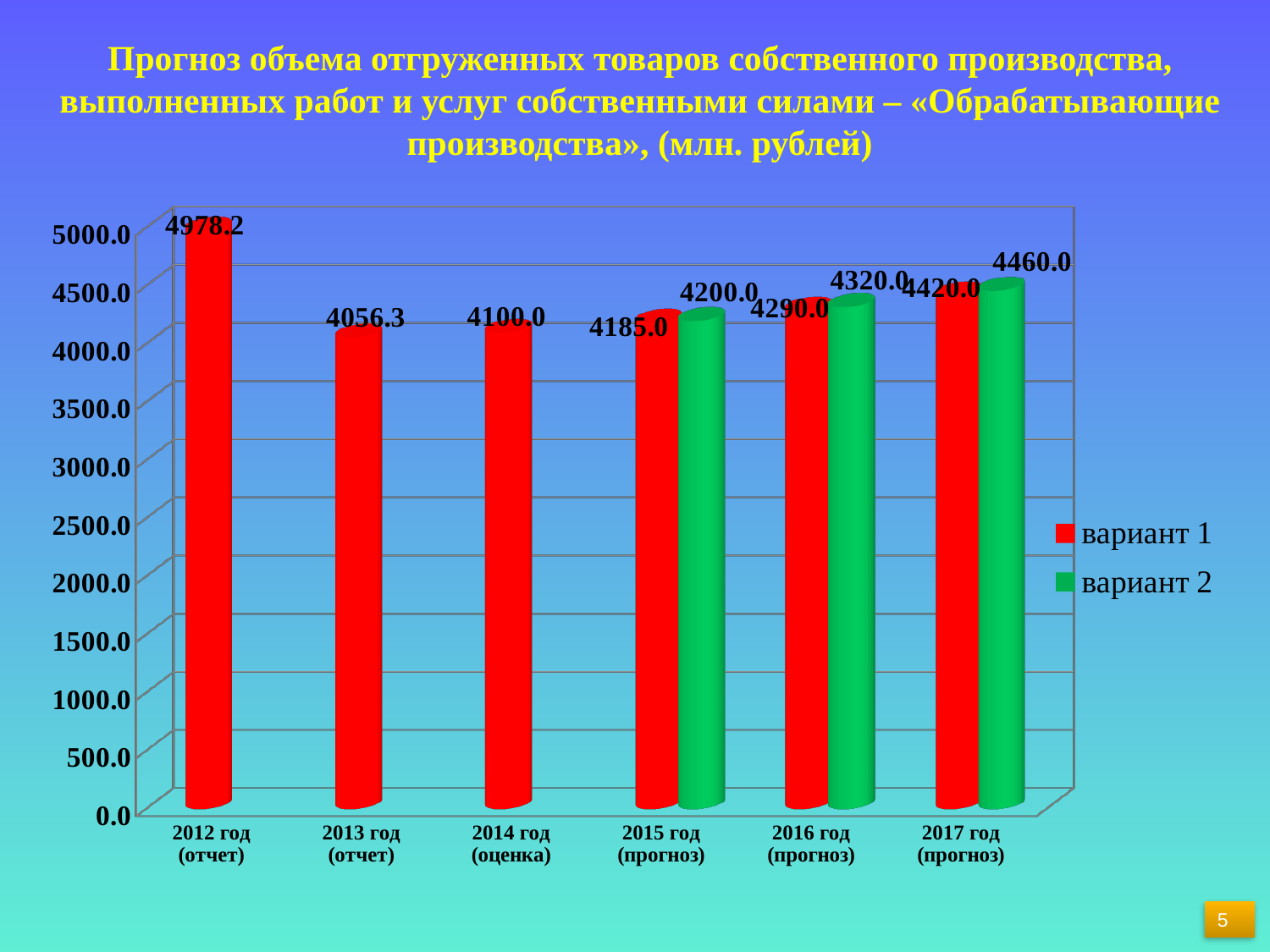
Which year has the lowest value for вариант 1? 2013 год (отчет) In 2015 год (прогноз), which is larger: вариант 1 or вариант 2? вариант 2 Which year has the highest value for вариант 1? 2012 год (отчет) What is the value for вариант 2 in 2017 год (прогноз)? 4460.0 What is the value for вариант 1 in 2016 год (прогноз)? 4290.0 What kind of chart is shown on the slide? bar chart How many series does the legend list? 2 What is the difference between вариант 2 and вариант 1 in 2017 год (прогноз)? 40.0 Do the values for вариант 1 rise or fall from 2013 год to 2017 год? rise What is the value for вариант 1 in 2013 год (отчет)? 4056.3 How many year categories are shown on the x axis? 6 What is the value for вариант 1 in 2012 год (отчет)? 4978.2